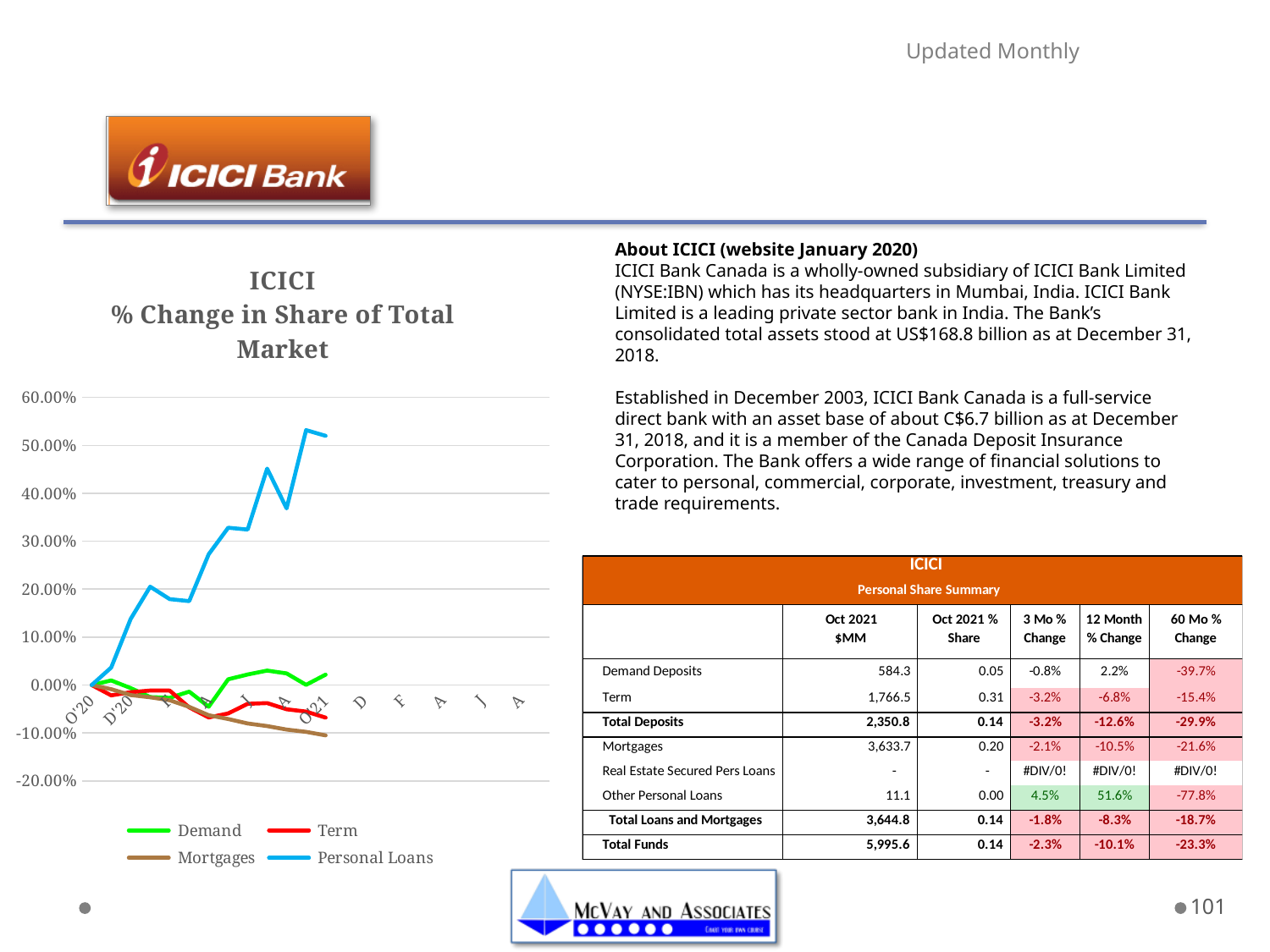
Is the highest value reached by the Personal Loans series greater or less than 40.00%? greater Which series is drawn in blue in the chart? Personal Loans Which series reaches the highest value on the chart? Personal Loans At O'21, which series has the larger value, Personal Loans or Term? Personal Loans Is the value for Term at O'21 greater or less than 0.00%? less Does the Personal Loans series generally rise or fall from O'20 to O'21? rise Does the Mortgages series generally rise or fall from O'20 to O'21? fall What is the title of the chart? ICICI % Change in Share of Total Market At O'21, which series has the larger value, Demand or Mortgages? Demand Is the value for Mortgages at O'21 greater or less than 0.00%? less What kind of chart is shown on the slide? Line chart How many series does the chart legend list? 4